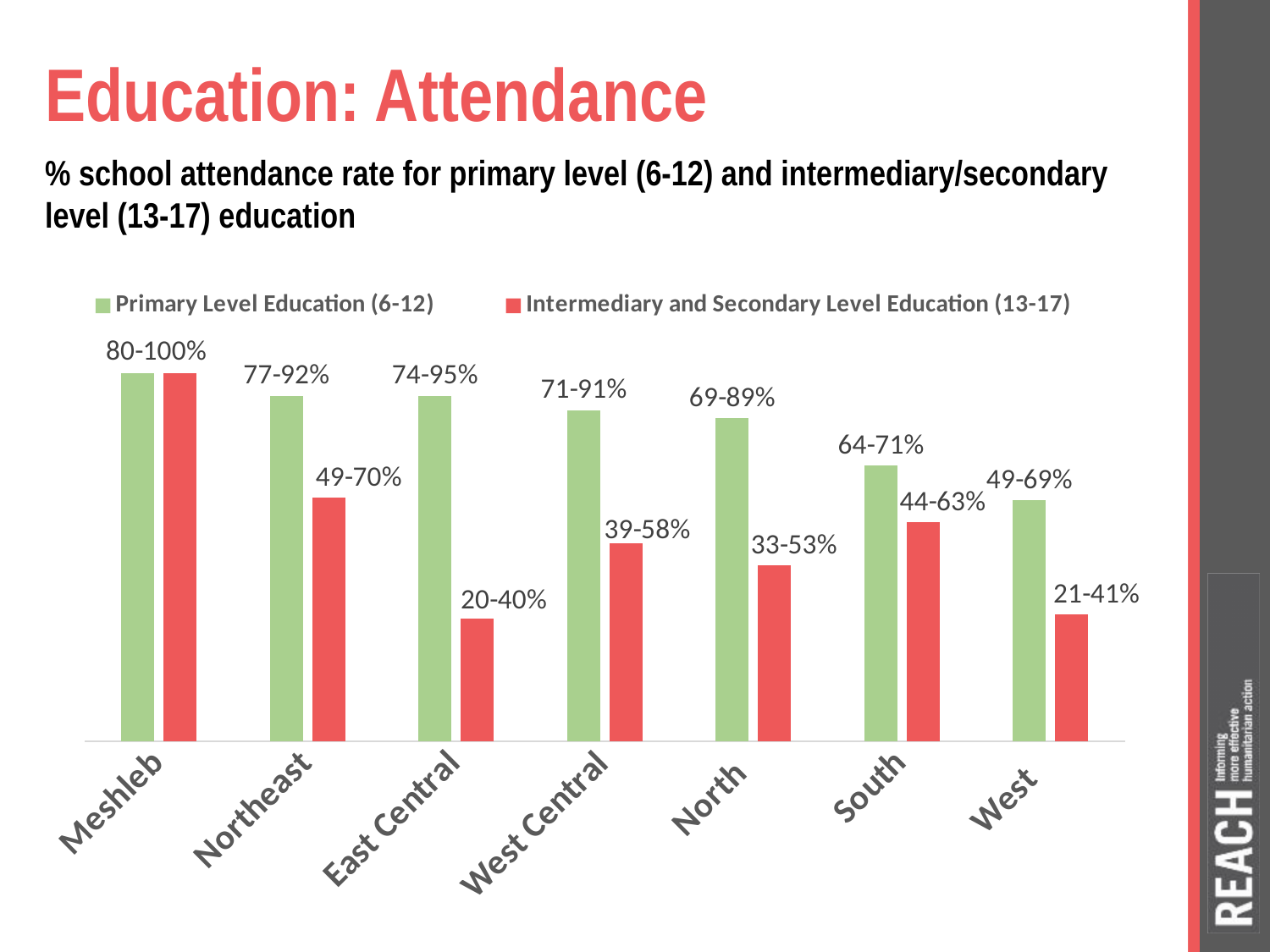
Which region has the lowest Primary Level Education (6-12) attendance rate? West What is the data label for Intermediary and Secondary Level Education (13-17) in East Central? 20-40% In Northeast, which is higher: Primary Level Education (6-12) or Intermediary and Secondary Level Education (13-17)? Primary Level Education (6-12) How many regions are shown on the x axis of the chart? 7 What is the data label for Intermediary and Secondary Level Education (13-17) in West? 21-41% What is the data label for Intermediary and Secondary Level Education (13-17) in South? 44-63% Which region has the lowest Intermediary and Secondary Level Education (13-17) attendance rate? East Central Which region has the highest Intermediary and Secondary Level Education (13-17) attendance rate? Meshleb How many series does the chart legend list? 2 What is the data label for Primary Level Education (6-12) in North? 69-89% What is the data label for Primary Level Education (6-12) in Meshleb? 80-100% What type of chart is shown on the slide? Bar chart